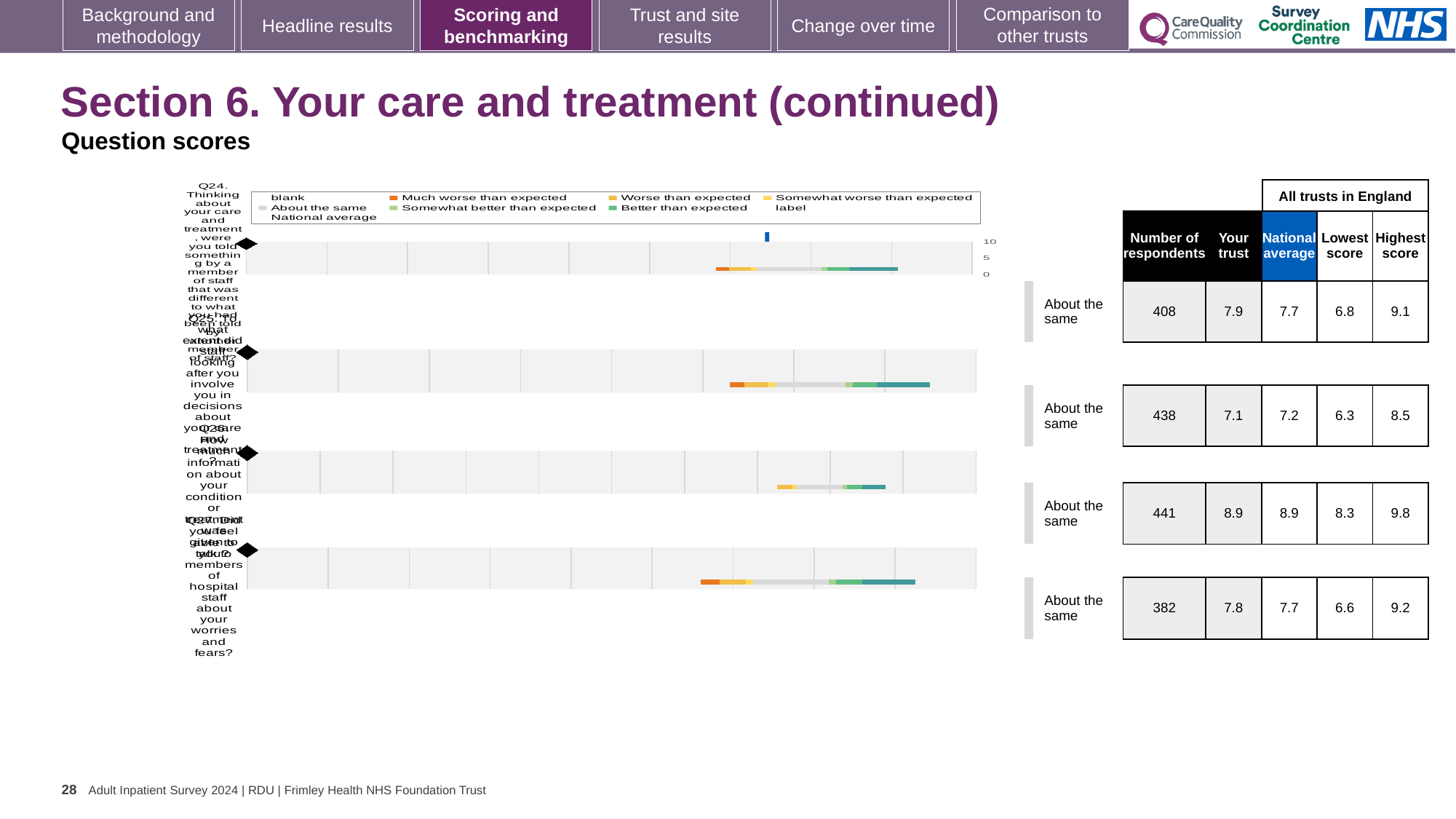
How many question rows (charts) are shown on the slide? 4 Which question row has the lowest number of respondents? Q27 (382) For the second chart row, Q25, what is the lowest score among all trusts in England? 6.3 What benchmark category is shown next to each of the four chart rows? About the same What kind of chart is used for the question score rows on this slide? bar chart For the first (top) chart row, Q24, what is the 'Your trust' score shown in the table? 7.9 For the second chart row, Q25, which is larger: the 'Your trust' score or the national average? National average (7.2) For the third chart row, Q26, what is the national average score? 8.9 For the second chart row, Q25, how many respondents are listed? 438 Which question row has the highest 'Your trust' score? Q26 (8.9) For the first chart row, Q24, what is the difference between the 'Your trust' score and the national average? 0.2 For the fourth (bottom) chart row, Q27, what is the highest score among all trusts in England? 9.2